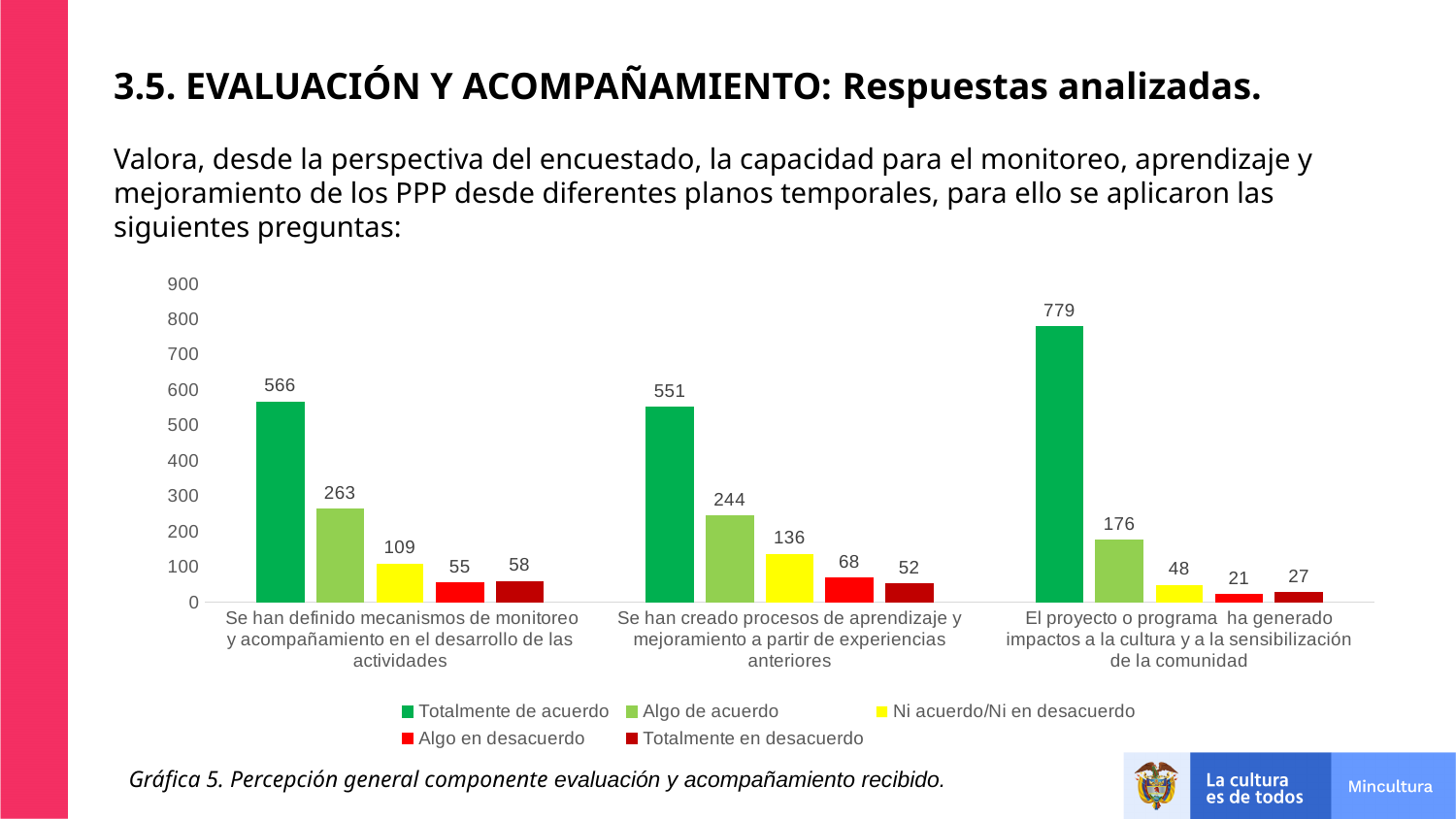
Which category has the highest value for "Totalmente de acuerdo"? El proyecto o programa ha generado impactos a la cultura y a la sensibilización de la comunidad What kind of chart is shown on the slide? Bar chart What is the value for "Totalmente de acuerdo" in the category "El proyecto o programa ha generado impactos a la cultura y a la sensibilización de la comunidad"? 779 How many categories are shown on the x axis of the chart? 3 Is the value for "Algo de acuerdo" in the category "El proyecto o programa ha generado impactos a la cultura y a la sensibilización de la comunidad" greater or less than 200? less What is the difference between the "Totalmente de acuerdo" values for "Se han definido mecanismos de monitoreo y acompañamiento en el desarrollo de las actividades" and "Se han creado procesos de aprendizaje y mejoramiento a partir de experiencias anteriores"? 15 What is the value for "Algo de acuerdo" in the category "Se han creado procesos de aprendizaje y mejoramiento a partir de experiencias anteriores"? 244 How many series does the legend list? 5 What colour are the bars for "Ni acuerdo/Ni en desacuerdo"? Yellow Which is larger: "Algo en desacuerdo" or "Totalmente en desacuerdo" in the category "Se han creado procesos de aprendizaje y mejoramiento a partir de experiencias anteriores"? Algo en desacuerdo What is the value for "Ni acuerdo/Ni en desacuerdo" in the category "Se han definido mecanismos de monitoreo y acompañamiento en el desarrollo de las actividades"? 109 Which series has the lowest value in the category "El proyecto o programa ha generado impactos a la cultura y a la sensibilización de la comunidad"? Algo en desacuerdo